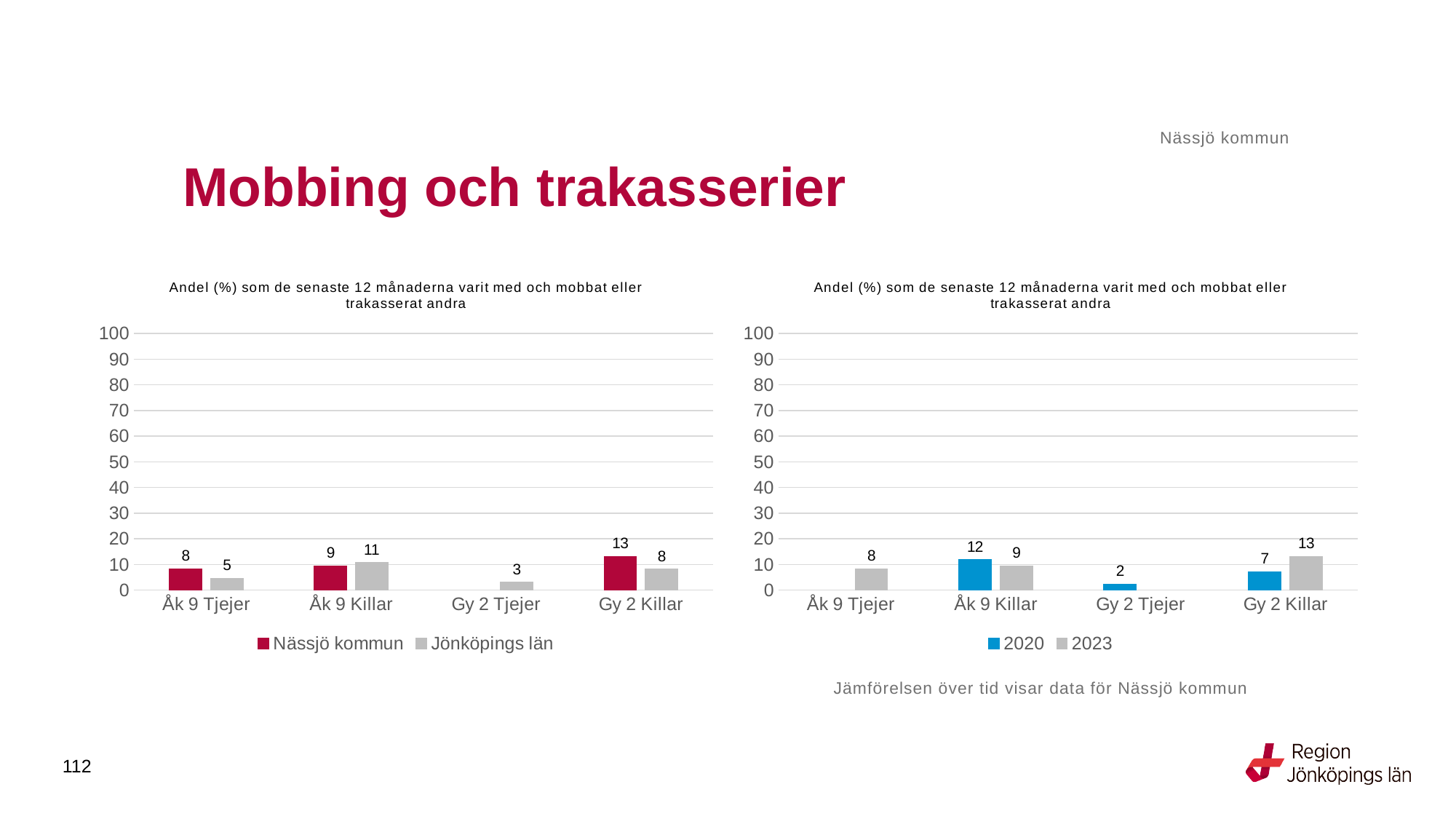
In the right chart, which category has the highest value for 2023? Gy 2 Killar In the right chart, what is the value for 2020 for Åk 9 Killar? 12 In the left chart, what is the value for Nässjö kommun for Gy 2 Killar? 13 In the left chart, what is the value for Jönköpings län for Åk 9 Killar? 11 In the right chart, what is the value for 2023 for Gy 2 Killar? 13 In the left chart, which category has the lowest value for Jönköpings län? Gy 2 Tjejer How many series does the legend of the right chart list? 2 In the left chart, which category has the highest value for Jönköpings län? Åk 9 Killar In the right chart, what is the difference between 2023 and 2020 for Gy 2 Killar? 6 In the left chart, what is the difference between Nässjö kommun and Jönköpings län for Gy 2 Killar? 5 In the left chart, which is larger for Åk 9 Killar: Nässjö kommun or Jönköpings län? Jönköpings län What kind of chart is the left chart? Bar chart